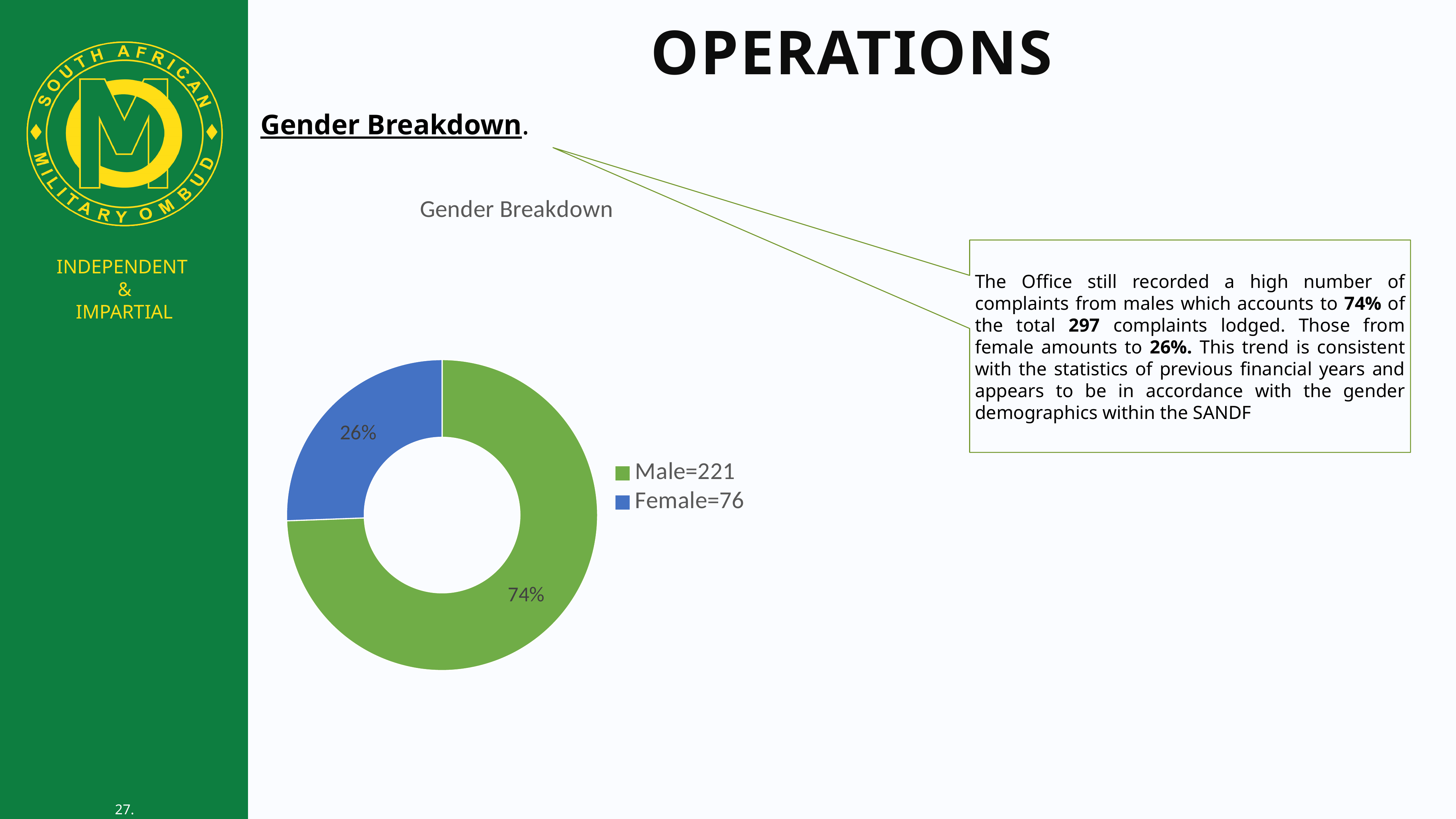
What count does the legend give for Female in the Gender Breakdown chart? 76 Which category has the largest share in the Gender Breakdown chart? Male What percentage of the Gender Breakdown chart is labelled for Male? 74% What colour represents Female in the Gender Breakdown chart? Blue What is the difference in percentage points between the Male and Female shares in the Gender Breakdown chart? 48 percentage points What percentage of the Gender Breakdown chart is labelled for Female? 26% What is the title of the chart on the slide? Gender Breakdown Which is larger in the Gender Breakdown chart, the Male share or the Female share? Male How many categories are shown in the Gender Breakdown chart? 2 Which category has the smallest share in the Gender Breakdown chart? Female What kind of chart is the Gender Breakdown chart? Doughnut (pie) chart What count does the legend give for Male in the Gender Breakdown chart? 221